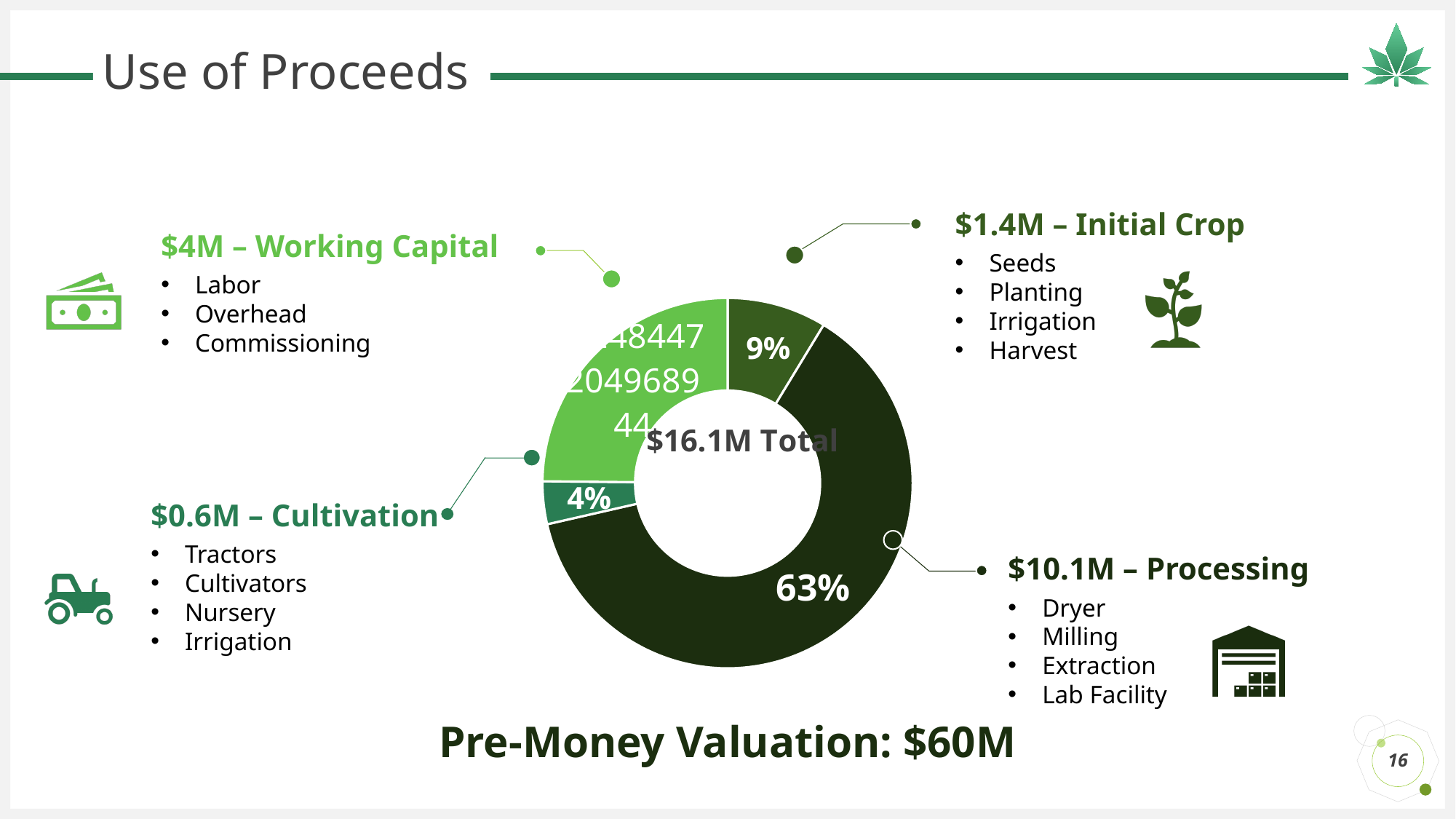
What is the difference in percentage points between the Processing share and the Initial Crop share? 54% What total amount is shown in the center of the donut chart? $16.1M Total Which is larger, the share for Initial Crop or the share for Cultivation? Initial Crop What kind of chart is shown on the slide? Pie chart (donut) What percentage of proceeds goes to Initial Crop? 9% What dollar amount is allocated to Working Capital? $4M What percentage of proceeds goes to Cultivation? 4% How many slices does the donut chart have? 4 Which use of proceeds has the smallest share of the chart? Cultivation What percentage of proceeds goes to Processing? 63% What dollar amount is allocated to Processing? $10.1M Which use of proceeds has the largest share of the chart? Processing